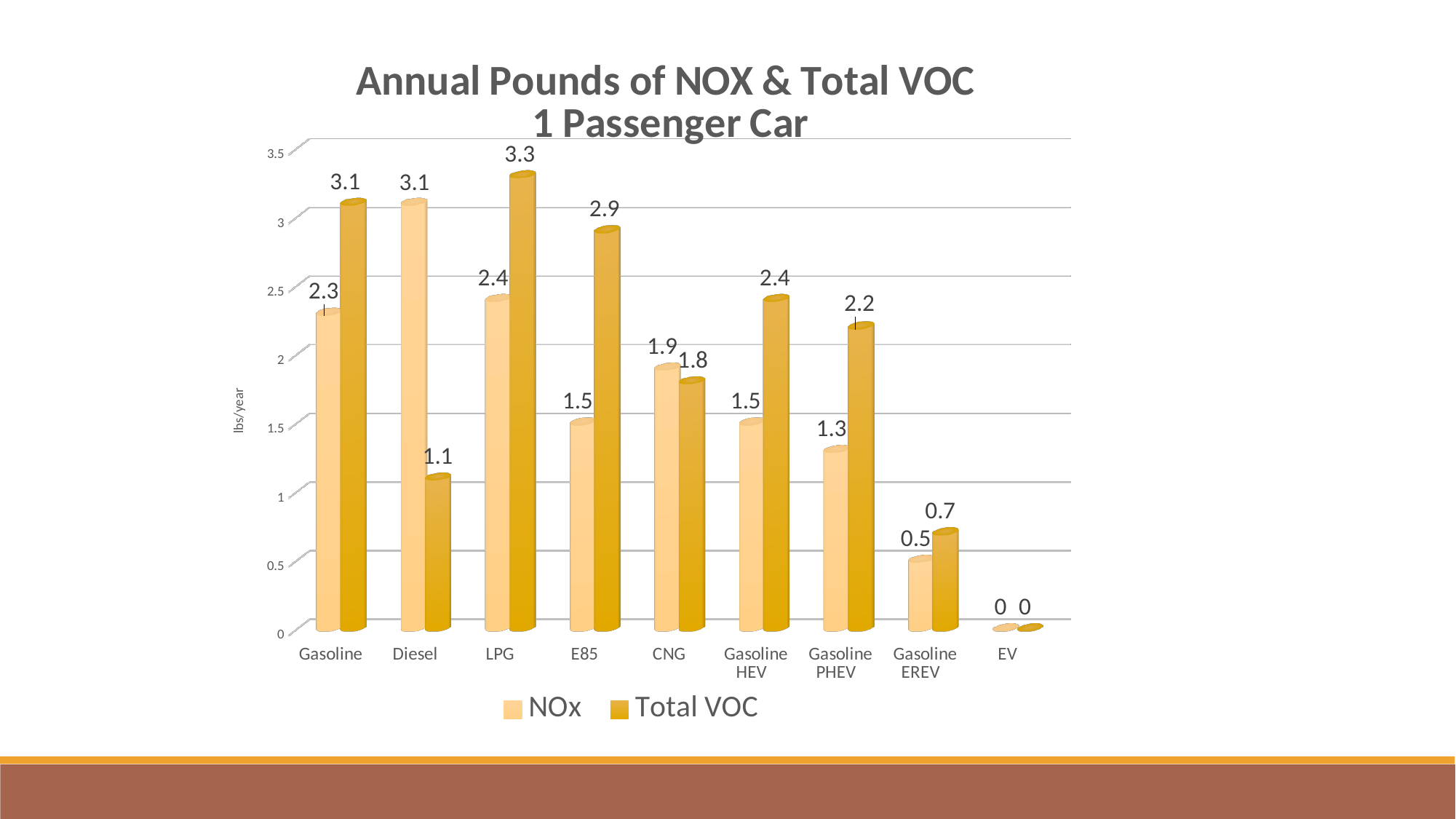
What is the Total VOC value for E85? 2.9 Which category has the highest Total VOC value? LPG Which category has the lowest NOx value? EV What is the difference between the Total VOC and NOx values for Diesel? 2 What unit is shown on the y axis label? lbs/year Which is larger for CNG, the NOx value or the Total VOC value? NOx What is the NOx value for Gasoline PHEV? 1.3 How many categories are shown on the x axis? 9 What is the NOx value for Diesel? 3.1 How many series does the legend list? 2 What kind of chart is shown on the slide? Bar chart What is the difference between the Total VOC values for LPG and Gasoline EREV? 2.6